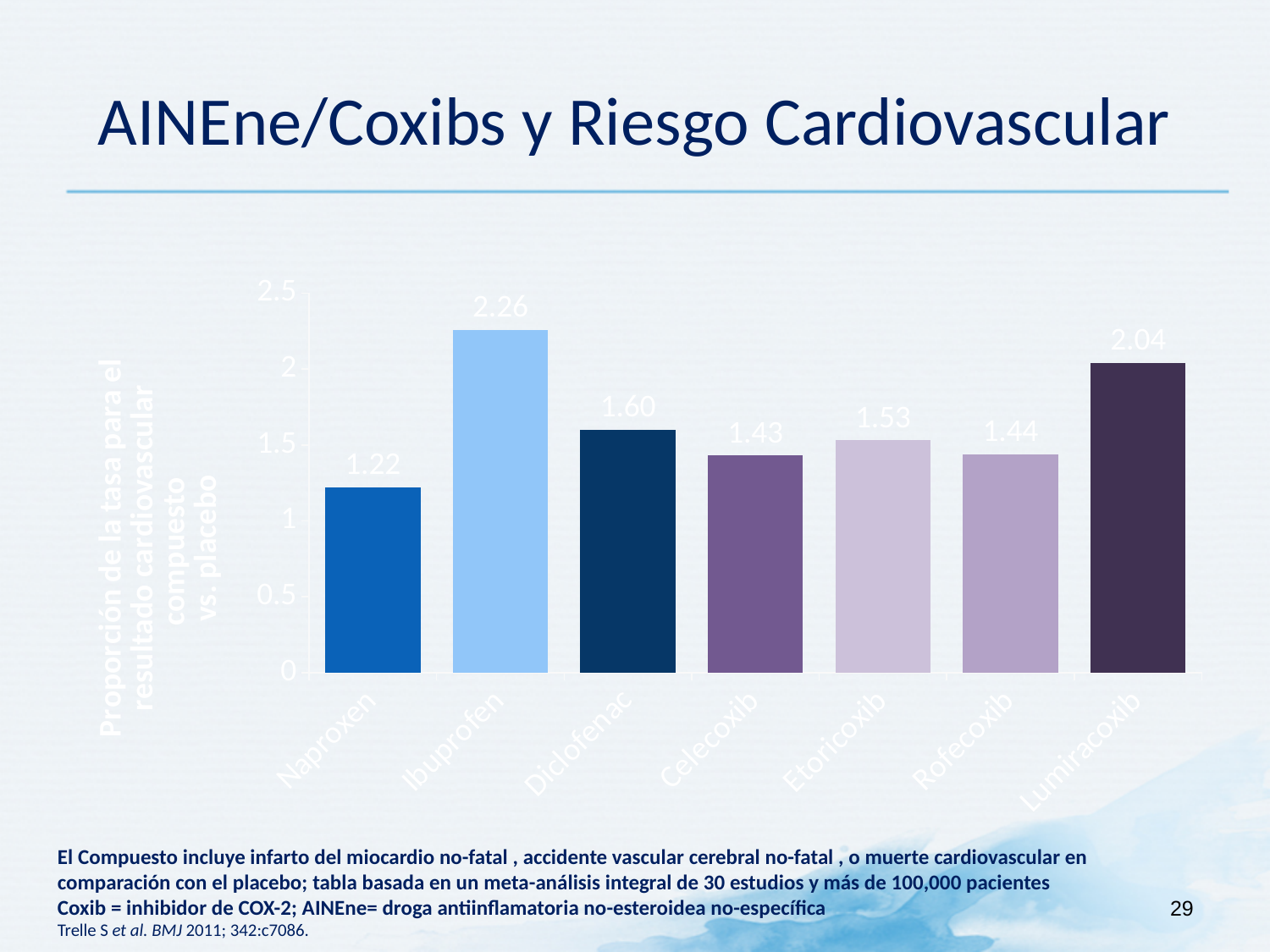
Is the value for Lumiracoxib greater or less than 2? greater How many drugs are shown on the x axis? 7 Which has a larger value, Diclofenac or Celecoxib? Diclofenac Which drug has the lowest value? Naproxen What is the value for Etoricoxib? 1.53 Which drug has the highest value? Ibuprofen What is the value for Lumiracoxib? 2.04 What is the difference between the values for Ibuprofen and Naproxen? 1.04 What is the value for Ibuprofen? 2.26 What is the difference between the values for Lumiracoxib and Diclofenac? 0.44 What is the value for Naproxen? 1.22 What kind of chart is shown on the slide? Bar chart